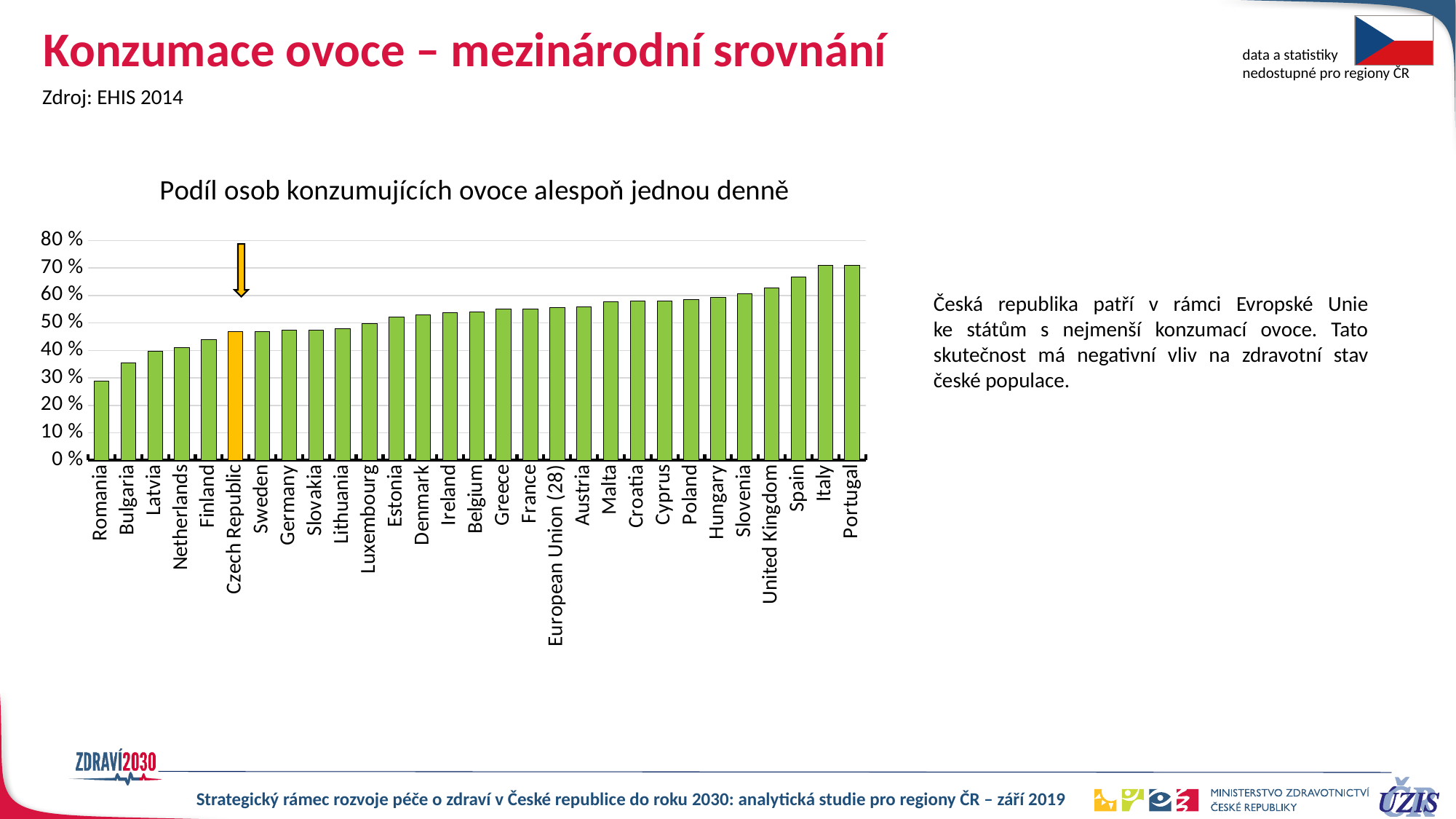
Is the value for Romania greater or less than 40 %? less Is the value for Netherlands greater or less than 50 %? less Which has a higher value, Romania or Bulgaria? Bulgaria Is the value for Czech Republic greater or less than 50 %? less Which country has the lowest share of people consuming fruit at least once a day? Romania Do the values rise or fall moving from left to right along the x axis? rise Which country's bar is highlighted in orange instead of green? Czech Republic What kind of chart is shown on the slide? bar chart Which has a higher value, Czech Republic or Spain? Spain How many categories (countries/regions) are plotted on the x axis? 29